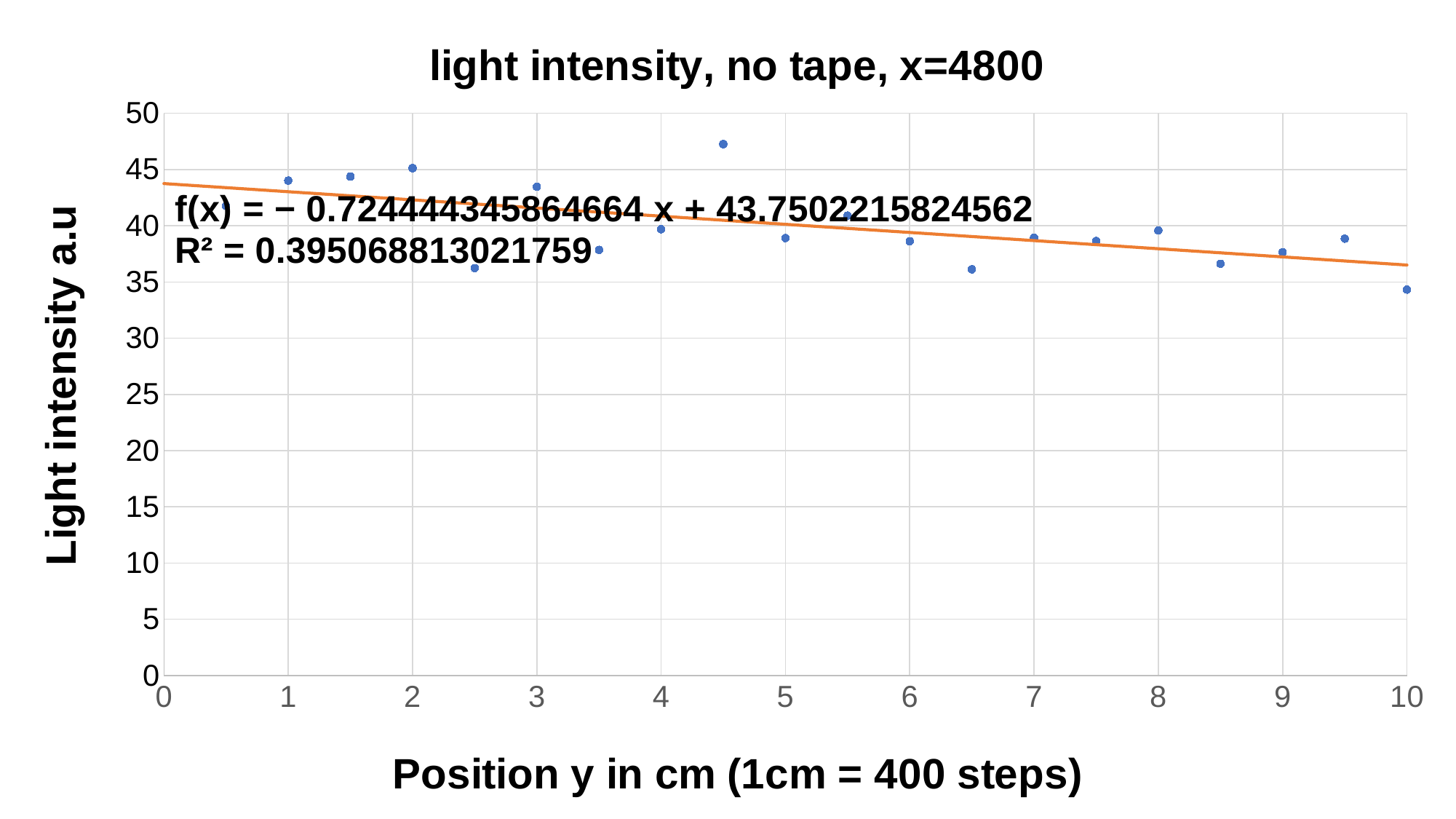
Which has the higher light intensity, position 1 or position 6.5? position 1 What kind of chart is shown on the slide? scatter chart At which position y is the light intensity lowest? 10 What is the title of the chart? light intensity, no tape, x=4800 Is the light intensity at position 10 greater or less than 35? less What R² value is printed on the chart? 0.395068813021759 At which position y is the light intensity highest? 4.5 Do the light intensity values generally rise or fall as position y increases? fall Is the light intensity at position 2.5 greater or less than 40? less Is the light intensity at position 1 greater or less than 40? greater